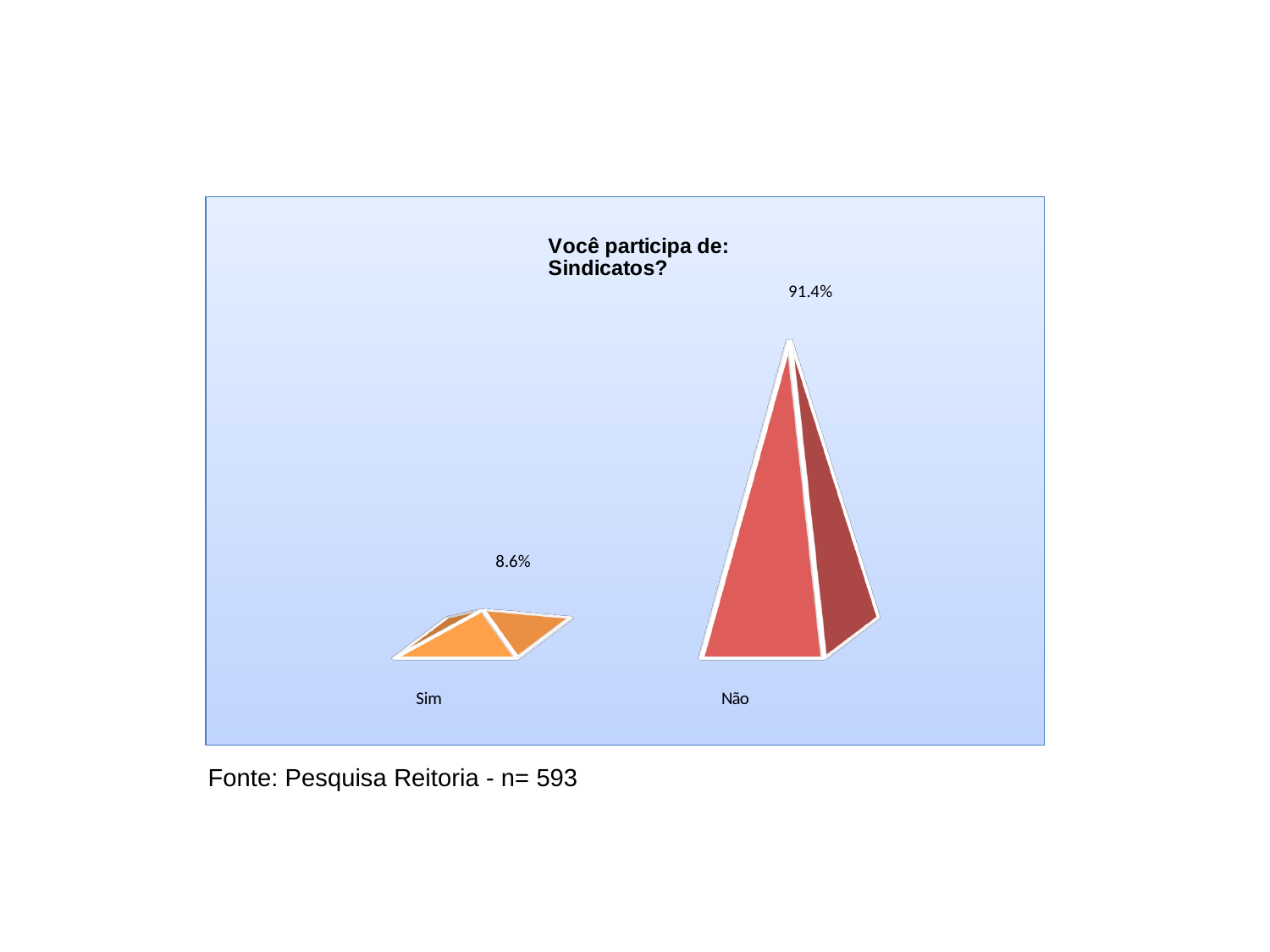
What is the difference between the values for Não and Sim? 82.8% What kind of chart is shown on the slide? Bar chart What is the value for Sim? 8.6% Which is larger, the value for Sim or the value for Não? Não What is the sample size (n) given in the source note below the chart? 593 Which category has the highest value? Não How many categories are shown in the chart? 2 What is the value for Não? 91.4% What is the title of the chart? Você participa de: Sindicatos? Which category has the lowest value? Sim